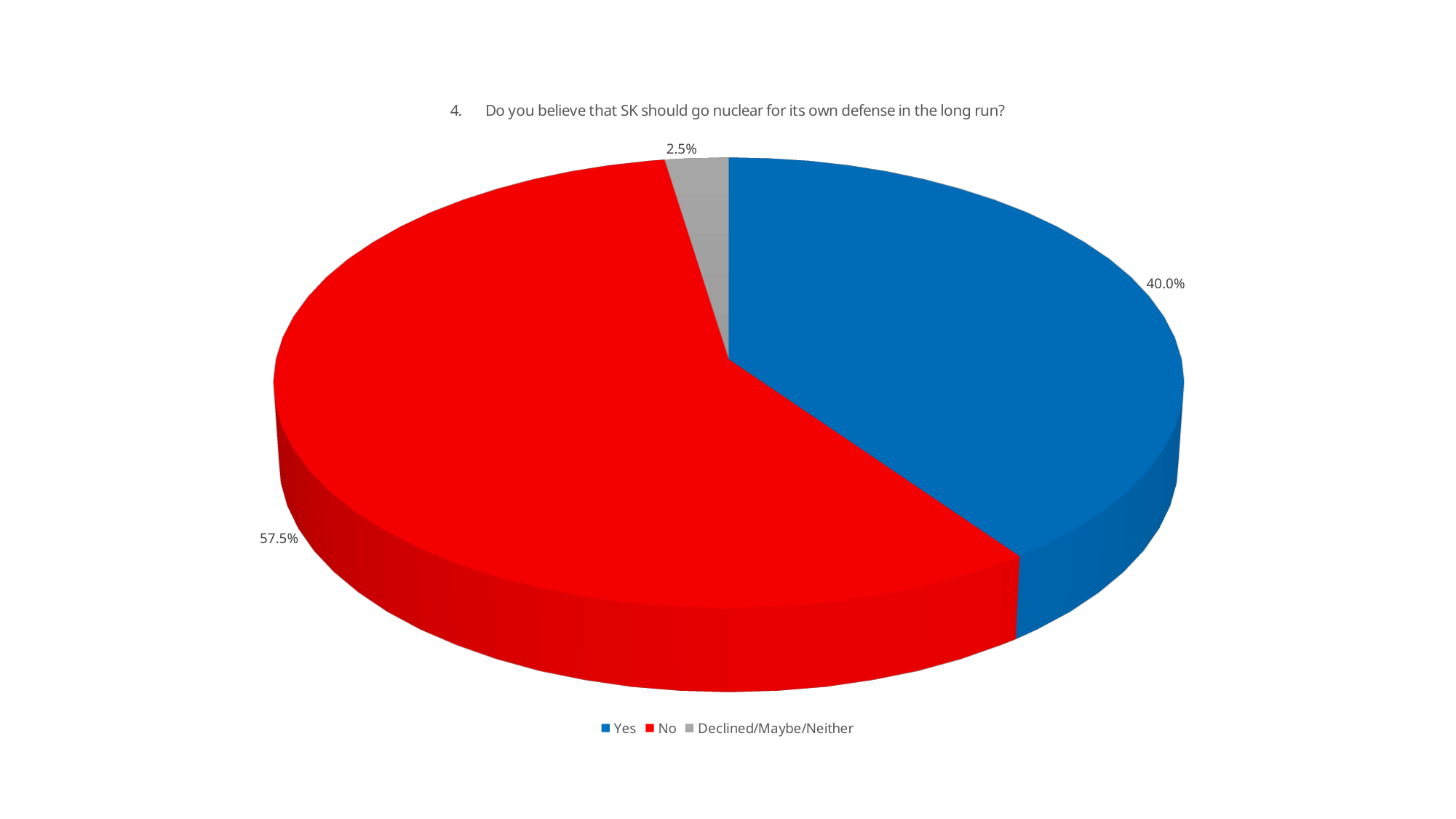
How many categories does the pie chart have? 3 What is the title of the chart? 4. Do you believe that SK should go nuclear for its own defense in the long run? What colour is the "No" slice? Red What percentage of respondents answered "No"? 57.5% Which is larger, the share for "Yes" or the share for "No"? No What kind of chart is shown on the slide? Pie chart How many entries does the legend list? 3 Which response has the largest share of the pie? No Which response has the smallest share of the pie? Declined/Maybe/Neither What percentage of respondents are in the "Declined/Maybe/Neither" category? 2.5% What percentage of respondents answered "Yes"? 40.0% What is the difference in percentage points between the "No" and "Yes" shares? 17.5